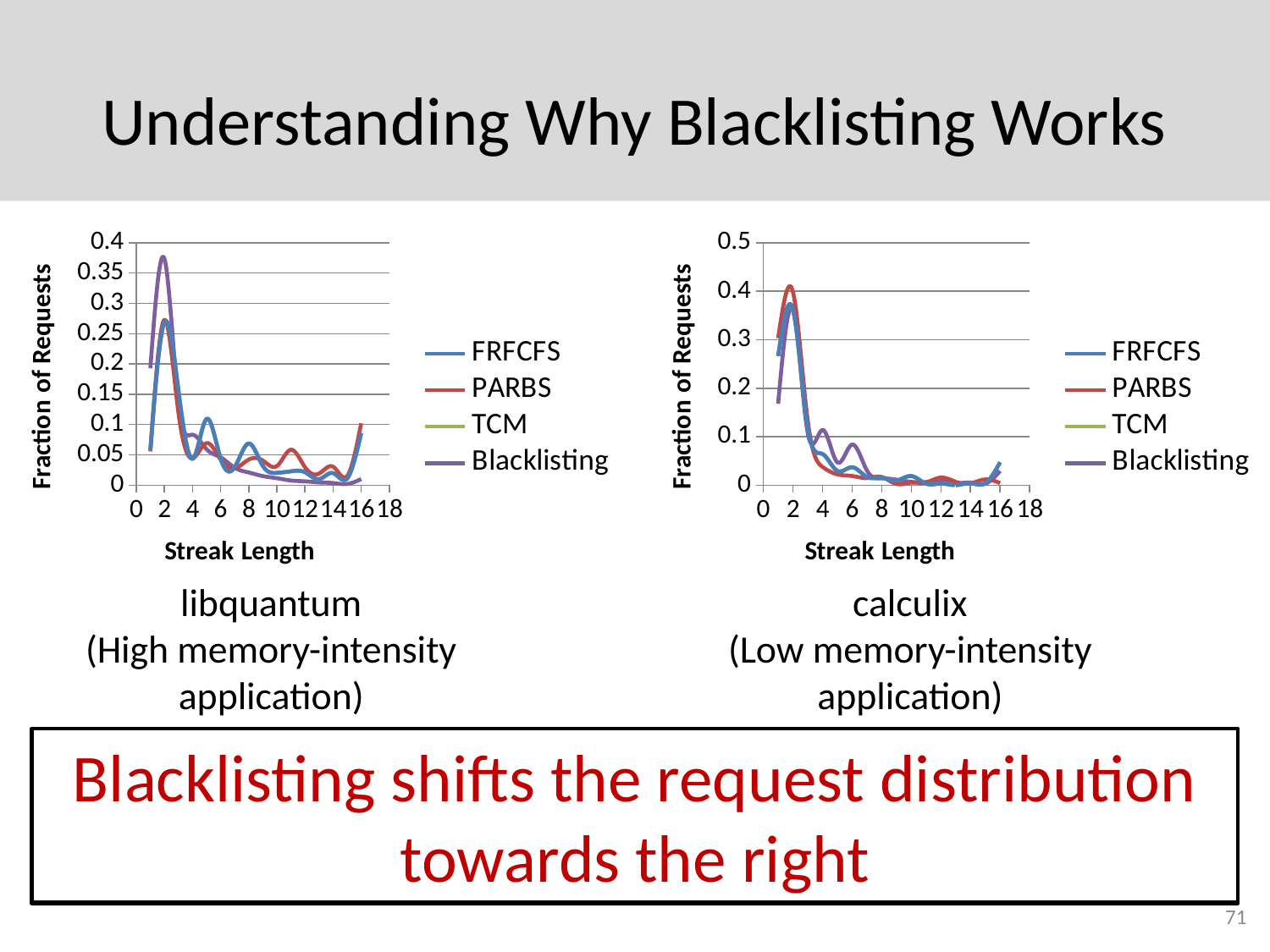
In the libquantum chart on the left, is the peak value of the PARBS series greater or less than 0.2? greater In the calculix chart on the right, which series reaches the highest peak? PARBS How many series does the legend of the calculix chart on the right list? 4 In the libquantum chart on the left, which series reaches the highest peak? Blacklisting What type of chart is the libquantum chart on the left? line chart In the calculix chart on the right, is the peak value of the FRFCFS series greater or less than 0.4? less In the libquantum chart on the left, is the peak value of the Blacklisting series greater or less than 0.3? greater In the libquantum chart on the left, do the values of the Blacklisting series generally rise or fall as streak length increases beyond 2? fall What is the x-axis title of the calculix chart on the right? Streak Length What is the y-axis title of the libquantum chart on the left? Fraction of Requests